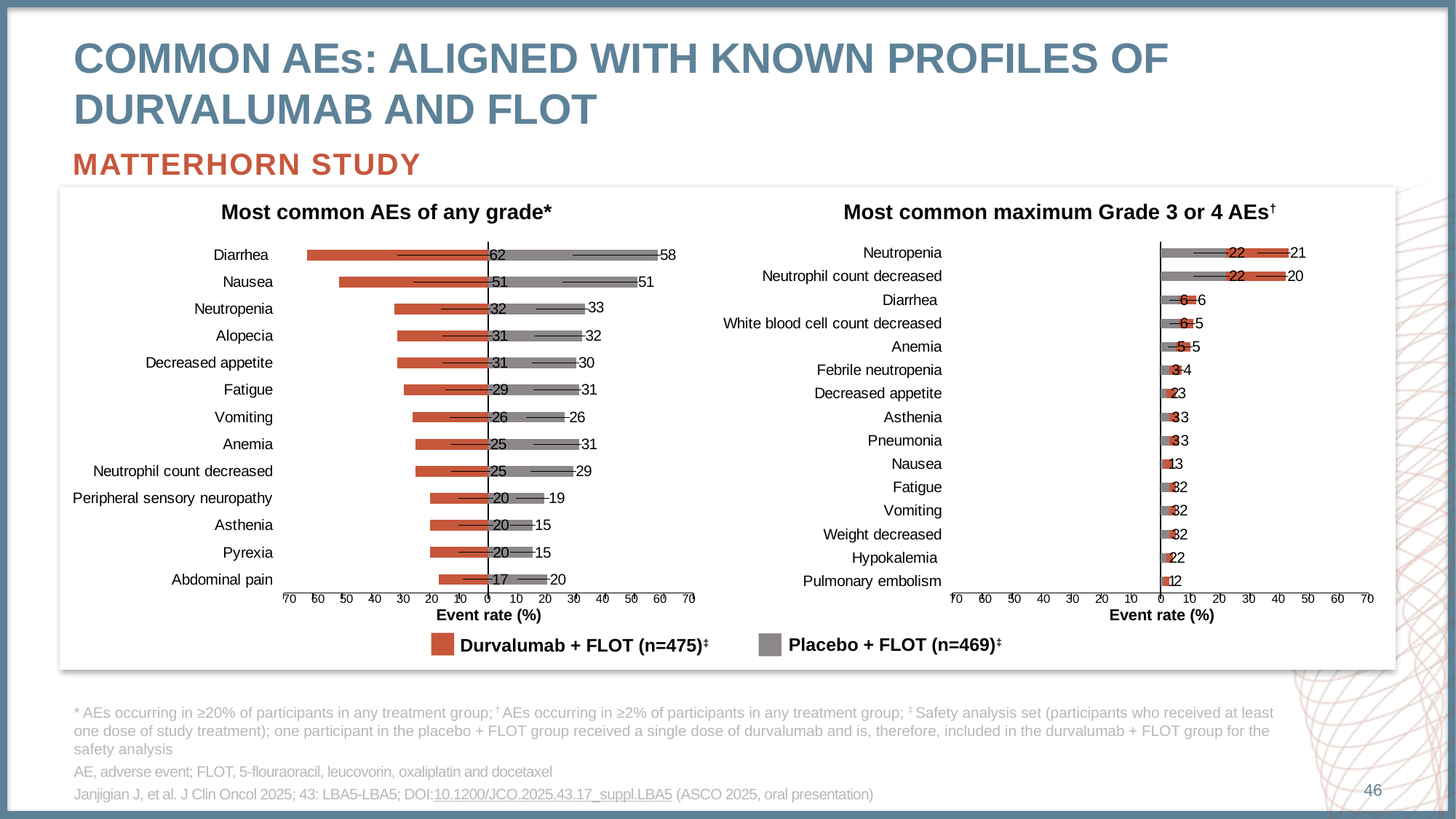
How many adverse events are listed in the 'Most common maximum Grade 3 or 4 AEs' chart? 15 In the 'Most common AEs of any grade' chart, what is the event rate for Diarrhea in the Durvalumab + FLOT group? 62 In the 'Most common AEs of any grade' chart, what is the difference between the Durvalumab + FLOT and Placebo + FLOT event rates for Diarrhea? 4 How many adverse events are listed in the 'Most common AEs of any grade' chart? 13 In the 'Most common maximum Grade 3 or 4 AEs' chart, what event rate is shown for Diarrhea in each group? 6 in both groups In the 'Most common AEs of any grade' chart, what is the event rate for Asthenia in the Placebo + FLOT group? 15 In the 'Most common AEs of any grade' chart, which group has the higher event rate for Anemia? Placebo + FLOT In the 'Most common AEs of any grade' chart, what is the event rate for Diarrhea in the Placebo + FLOT group? 58 What type of chart is used for 'Most common AEs of any grade'? Bar chart According to the legend, how many participants are in the Durvalumab + FLOT group? n=475 How many treatment groups does the legend list? 2 In the 'Most common AEs of any grade' chart, which adverse event has the highest event rate? Diarrhea